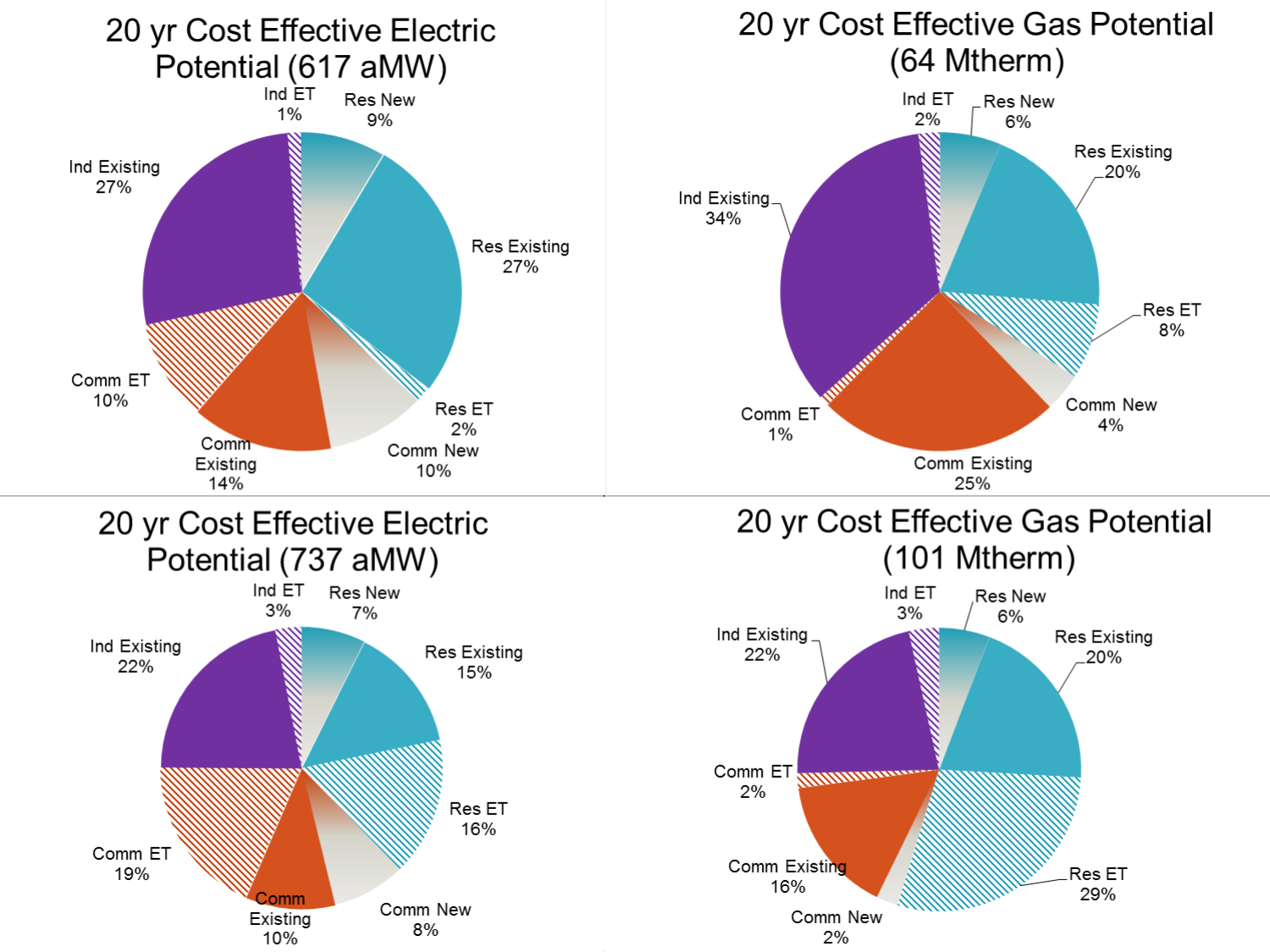
In the '20 yr Cost Effective Gas Potential (64 Mtherm)' chart, which category has the largest share? Ind Existing In the '20 yr Cost Effective Electric Potential (737 aMW)' chart, what share does Comm ET have? 19% In the '20 yr Cost Effective Electric Potential (617 aMW)' chart, what share does Comm Existing have? 14% In the '20 yr Cost Effective Electric Potential (617 aMW)' chart, which category has the smallest share? Ind ET What type of chart is the '20 yr Cost Effective Electric Potential (617 aMW)' chart? Pie chart In the '20 yr Cost Effective Gas Potential (101 Mtherm)' chart, which category has the largest share? Res ET In the '20 yr Cost Effective Gas Potential (64 Mtherm)' chart, what share does Res ET have? 8% In the '20 yr Cost Effective Electric Potential (737 aMW)' chart, which is larger, Res ET or Res Existing? Res ET In the '20 yr Cost Effective Electric Potential (737 aMW)' chart, which category has the largest share? Ind Existing In the '20 yr Cost Effective Gas Potential (64 Mtherm)' chart, what is the difference between the Ind Existing and Comm Existing shares? 9% In the '20 yr Cost Effective Gas Potential (101 Mtherm)' chart, what share does Comm Existing have? 16% How many slices does the '20 yr Cost Effective Gas Potential (101 Mtherm)' chart have? 8